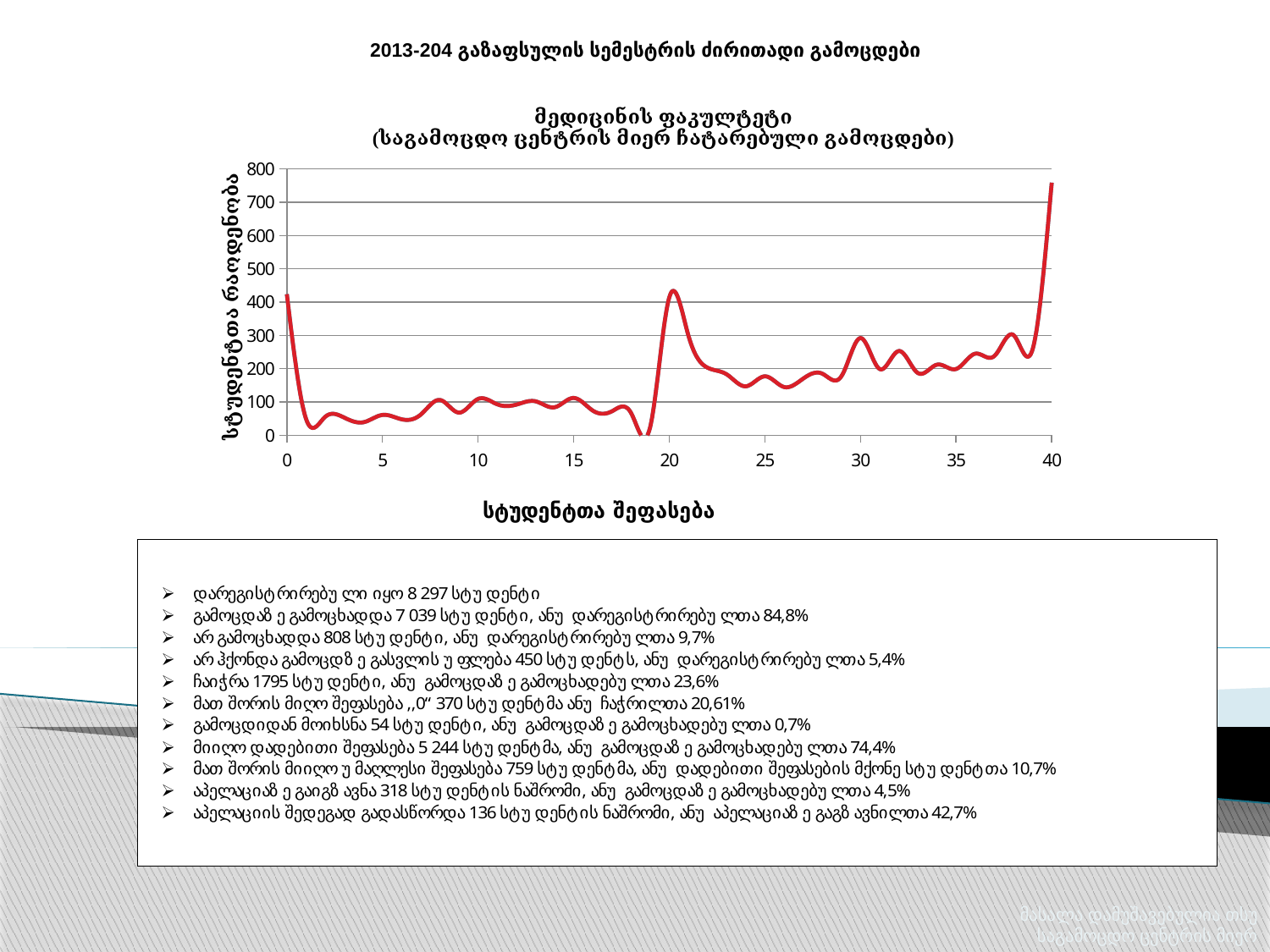
Is the value of the line at x = 5 greater or less than 100? less Is the value of the line at x = 0 greater or less than 300? greater Does the line rise or fall between x = 38 and x = 40? rise Is the value of the line at x = 25 greater or less than 200? less Which is larger, the value of the line at x = 20 or at x = 10? x = 20 What is the label of the vertical axis of the chart? სტუდენტთა რაოდენობა What is the highest value shown on the vertical axis? 800 What kind of chart is shown on the slide? line chart What is the title of the chart? სტუდენტთა შეფასება At which x value does the line reach its highest point? 40